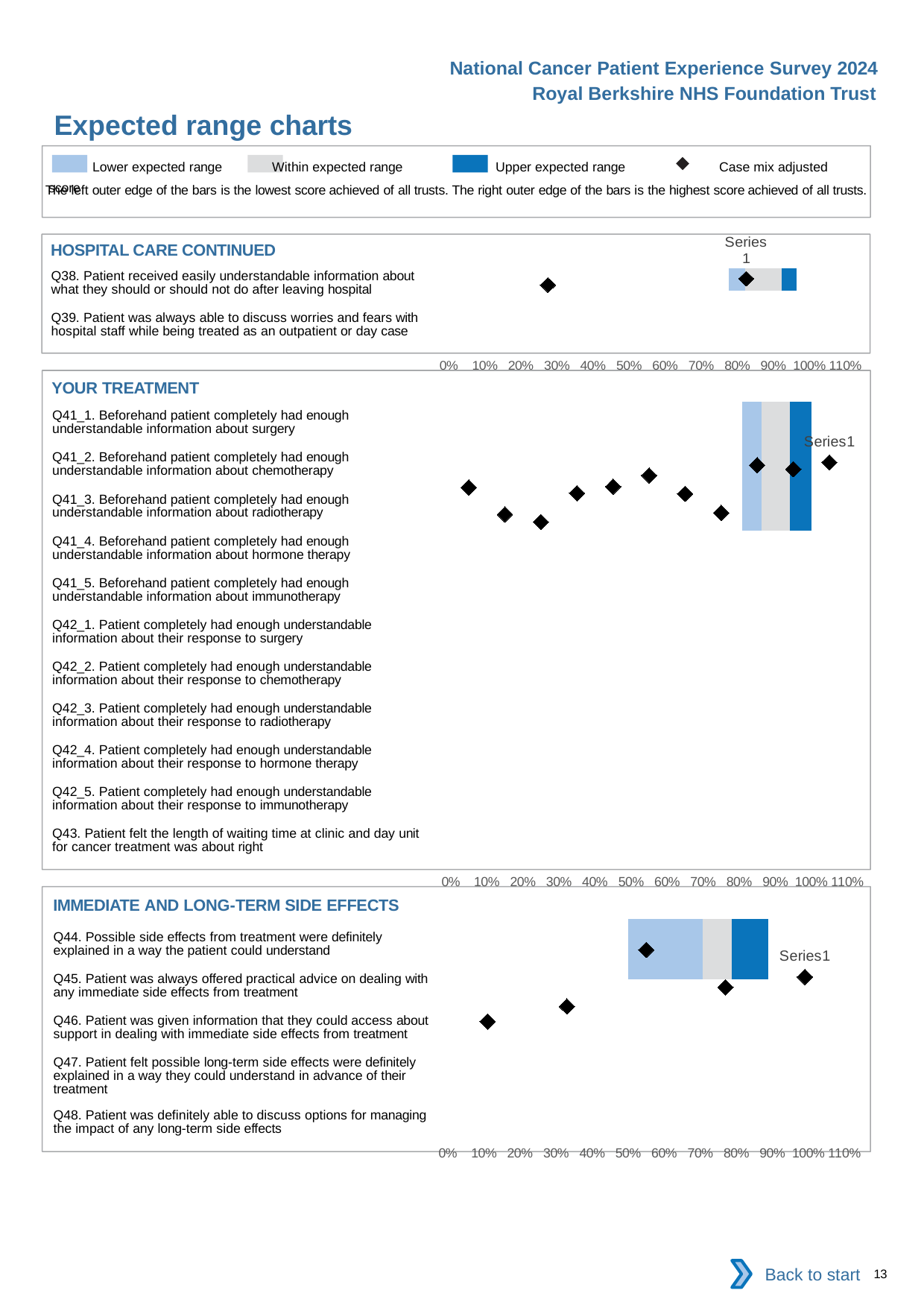
In the IMMEDIATE AND LONG-TERM SIDE EFFECTS chart, how many questions are listed? 5 Which of the three charts on the slide lists the most questions? YOUR TREATMENT How many entries does the legend at the top of the slide list? 4 In the HOSPITAL CARE CONTINUED chart, how many questions are listed? 2 In the YOUR TREATMENT chart, how many questions are listed? 11 According to the legend, what symbol marks the case mix adjusted score? A diamond What is the highest tick label shown on the x axis of the charts? 110%